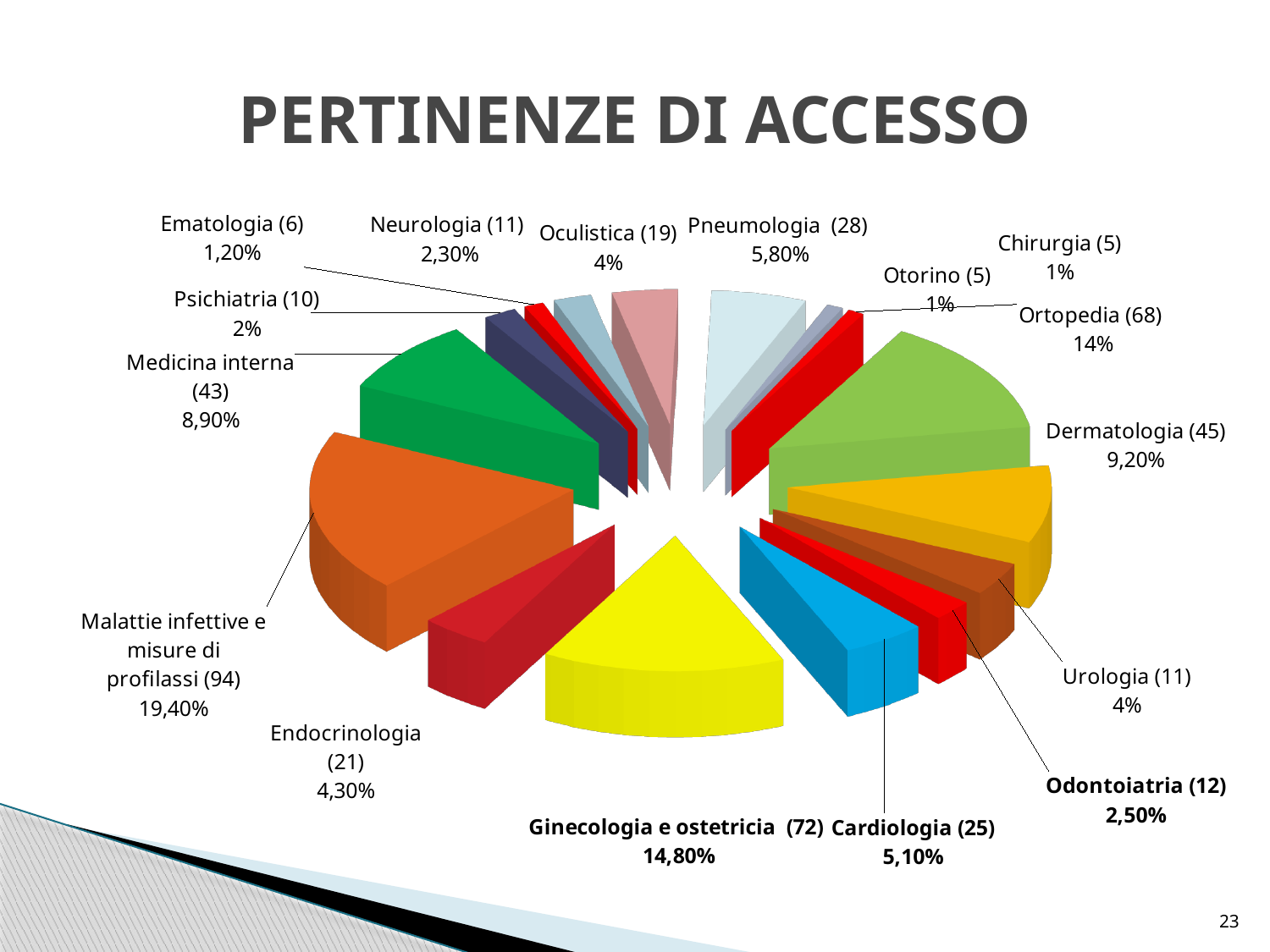
What percentage share is shown for Ginecologia e ostetricia? 14,80% How many categories are shown in the pie chart? 16 What is the difference in count between Ginecologia e ostetricia (72) and Ortopedia (68)? 4 What percentage share is shown for Medicina interna? 8,90% What kind of chart is shown on the slide? Pie chart What count is shown in parentheses for Ortopedia? 68 Which is larger, the share for Dermatologia or the share for Pneumologia? Dermatologia What percentage share is shown for Odontoiatria? 2,50% Which category has the smallest count shown in parentheses, Ematologia or Chirurgia? Chirurgia Which category has the largest share of the pie? Malattie infettive e misure di profilassi What percentage share is shown for Malattie infettive e misure di profilassi? 19,40% What is the title of the chart on the slide? PERTINENZE DI ACCESSO